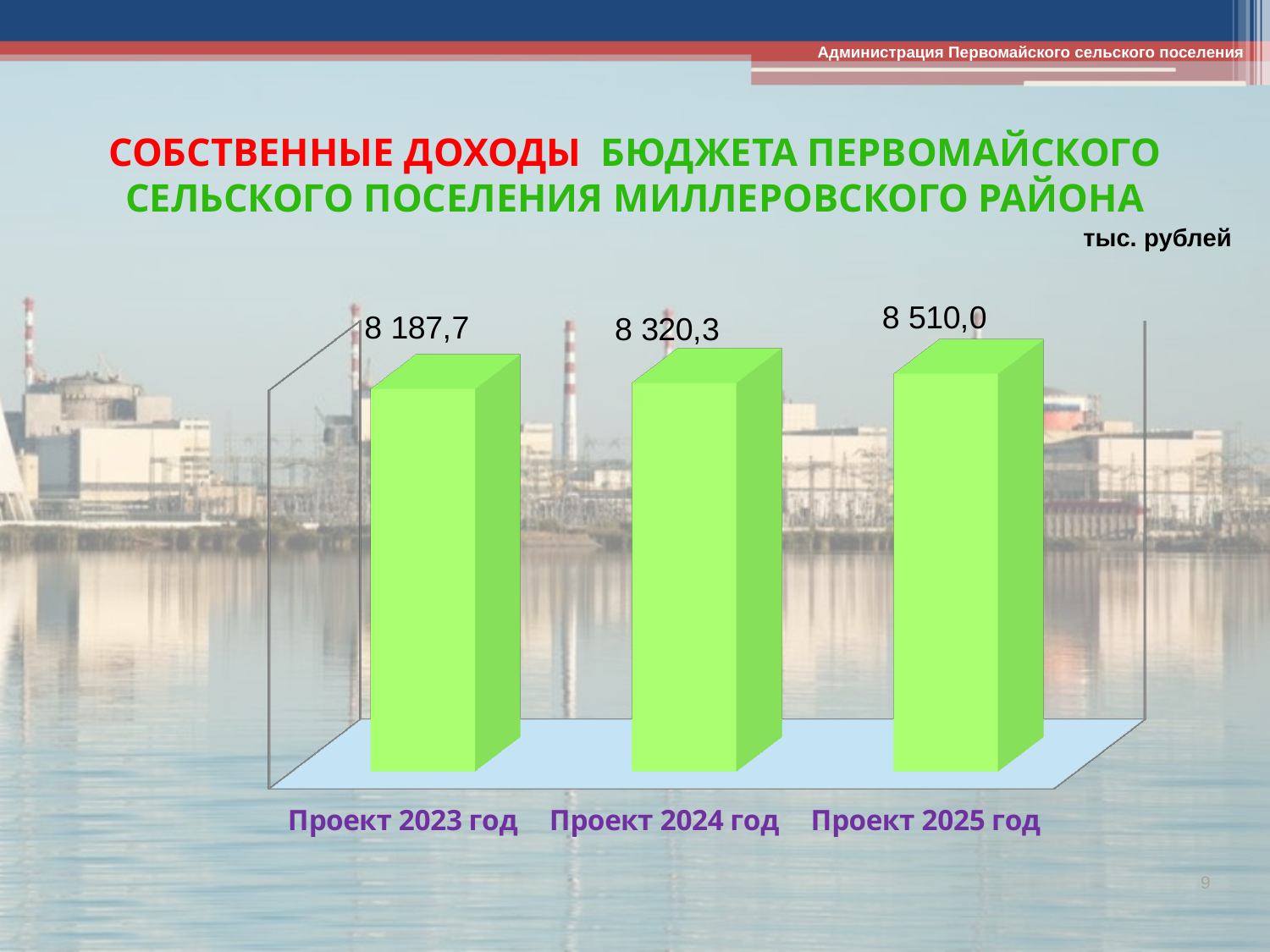
What is the difference between the values for Проект 2024 год and Проект 2023 год? 132,6 What is the difference between the values for Проект 2025 год and Проект 2024 год? 189,7 What is the difference between the values for Проект 2025 год and Проект 2023 год? 322,3 How many categories are shown in the chart? 3 What is the value for Проект 2024 год? 8 320,3 Which category has the highest value? Проект 2025 год What is the value for Проект 2023 год? 8 187,7 What kind of chart is shown on the slide? Bar chart Do the values rise or fall from Проект 2023 год to Проект 2025 год? Rise Which category has the lowest value? Проект 2023 год Which is larger, the value for Проект 2024 год or Проект 2025 год? Проект 2025 год What is the value for Проект 2025 год? 8 510,0